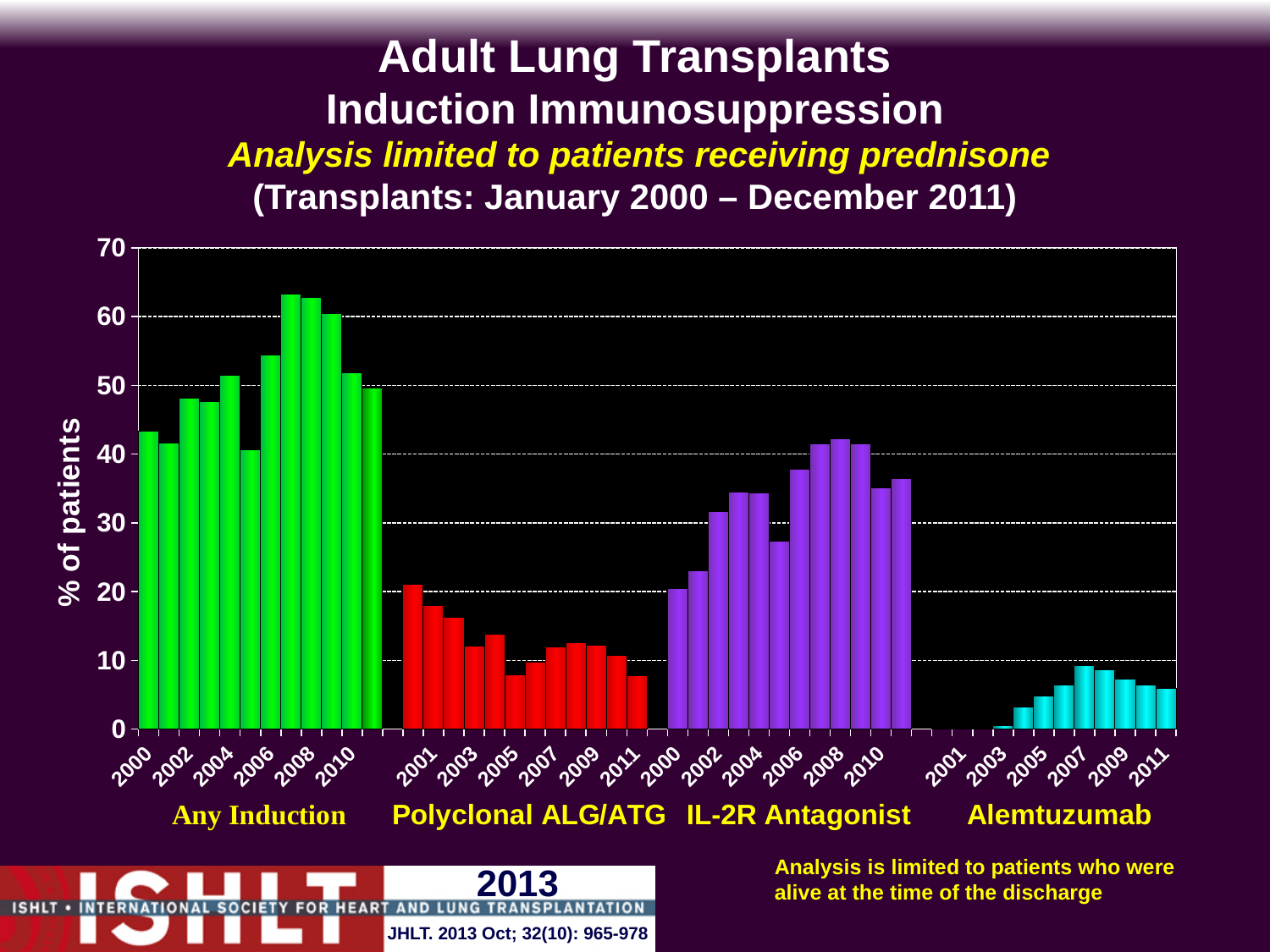
In the Polyclonal ALG/ATG group, which year has the highest % of patients? 2000 Do the IL-2R Antagonist values rise or fall from 2000 to 2003? rise What kind of chart is shown on the slide? bar chart Is the value for Any Induction in 2007 greater or less than 60? greater How many induction groups are shown along the x axis of the chart? 4 Is the value for IL-2R Antagonist in 2000 greater or less than 30? less What is the label on the y axis of the chart? % of patients Which is larger in 2008: the value for IL-2R Antagonist or the value for Polyclonal ALG/ATG? IL-2R Antagonist Do the Polyclonal ALG/ATG values rise or fall from 2000 to 2005? fall Is the value for Any Induction in 2005 greater or less than 50? less